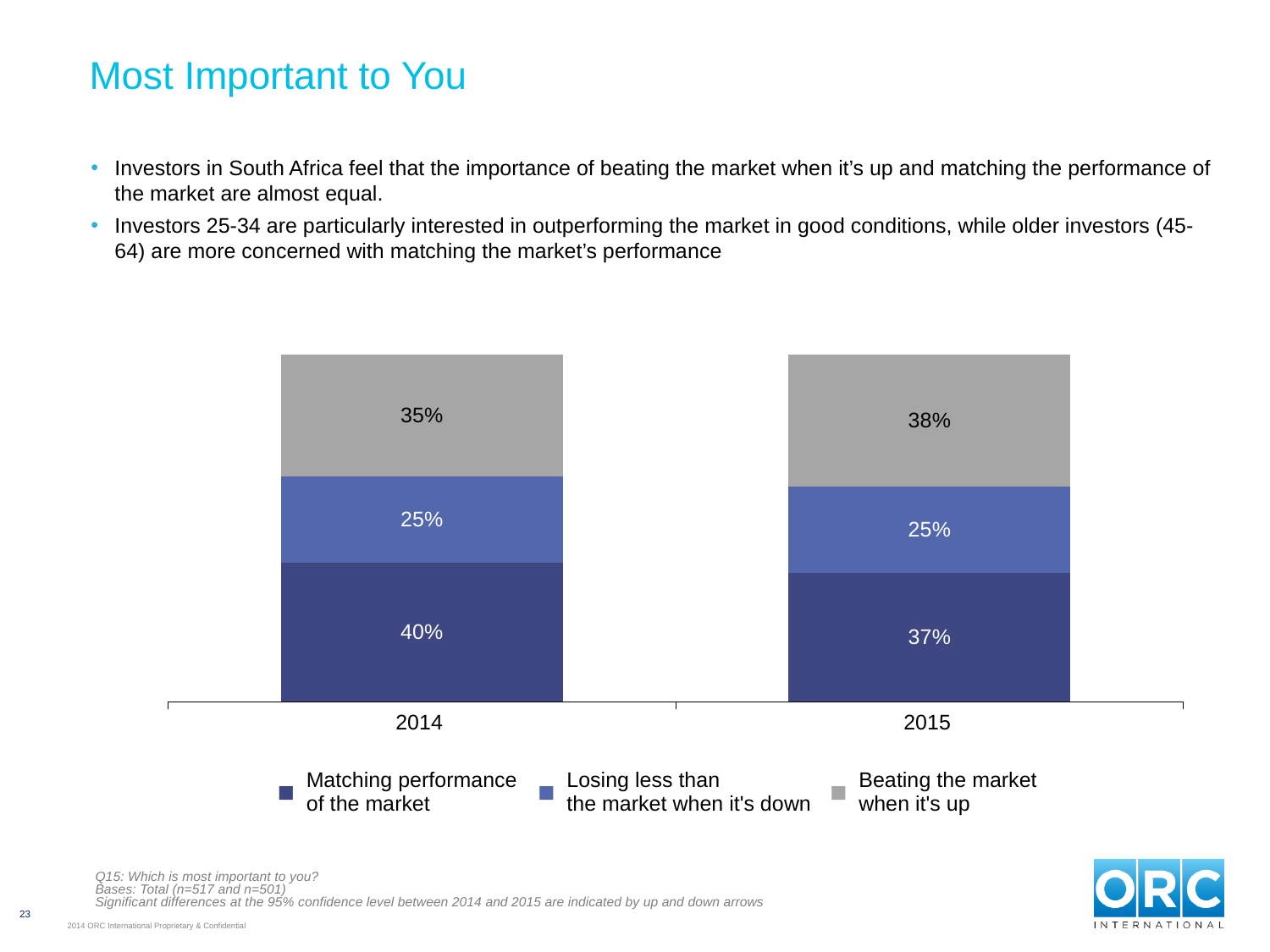
What percentage of investors in 2014 chose 'Matching performance of the market'? 40% How many series does the legend list? 3 What kind of chart is shown on the slide? Stacked bar chart Which option had the lowest share in 2015? Losing less than the market when it's down What is the value for 'Beating the market when it's up' in 2014? 35% What percentage of investors in 2015 chose 'Beating the market when it's up'? 38% Which option had the highest share in 2014? Matching performance of the market Did the share for 'Beating the market when it's up' rise or fall from 2014 to 2015? Rise What is the value for 'Losing less than the market when it's down' in 2015? 25% How many years are shown on the x axis? 2 Which is larger in 2015: 'Beating the market when it's up' or 'Matching performance of the market'? Beating the market when it's up By how many percentage points did 'Matching performance of the market' change from 2014 to 2015? 3 percentage points lower